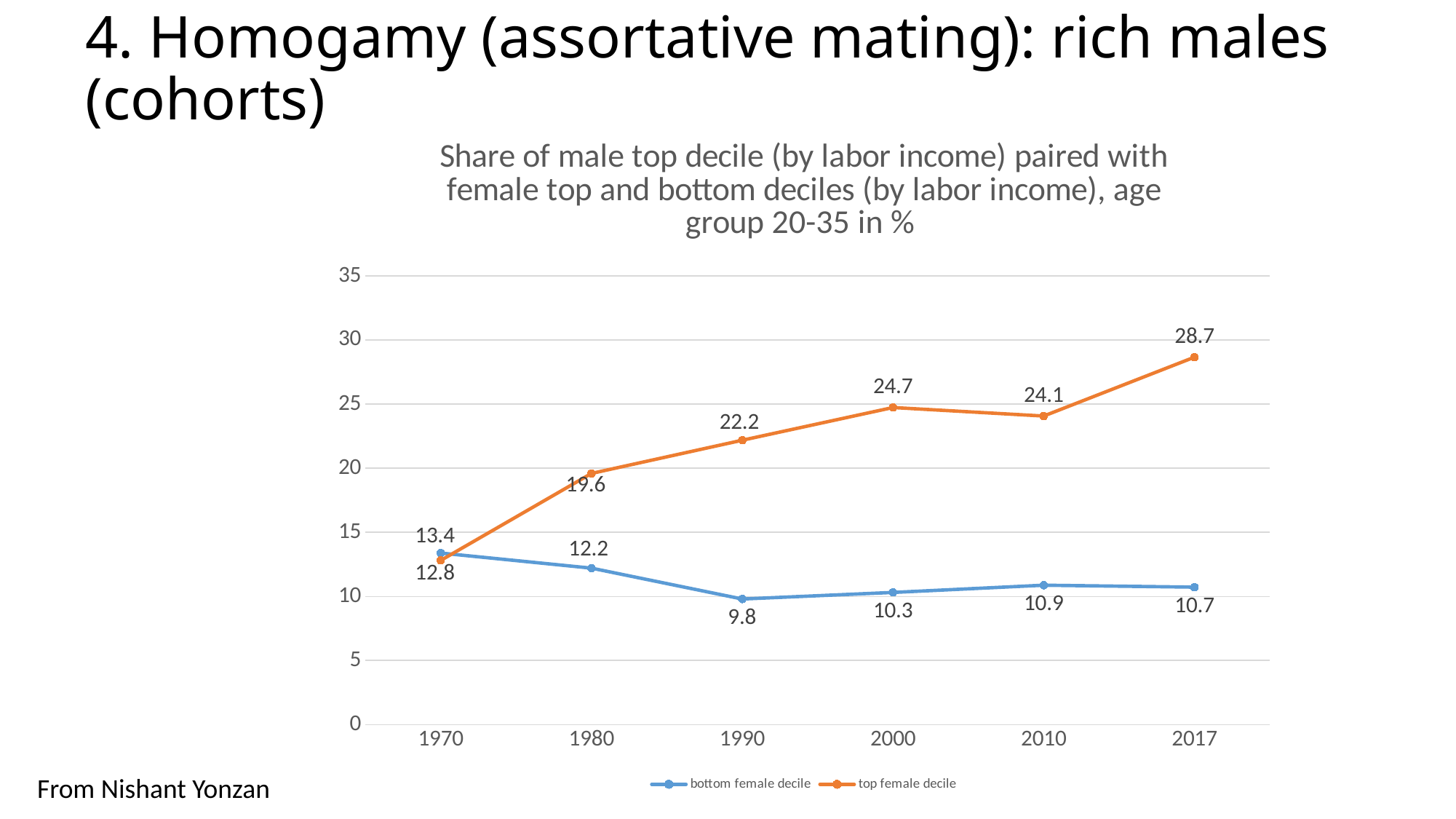
What is the value for the top female decile in 1970? 12.8 Which series has the larger value in 1970, bottom female decile or top female decile? bottom female decile Does the top female decile series generally rise or fall from 1970 to 2017? rise What is the value for the top female decile in 2017? 28.7 In which year is the bottom female decile series lowest? 1990 What is the value for the bottom female decile in 1990? 9.8 What is the difference between the top female decile and bottom female decile values in 2000? 14.4 In which year is the top female decile series highest? 2017 What kind of chart is shown on the slide? line chart How many years are shown on the x axis? 6 Is the value for the top female decile in 2010 greater or less than 20? greater How many series does the legend list? 2